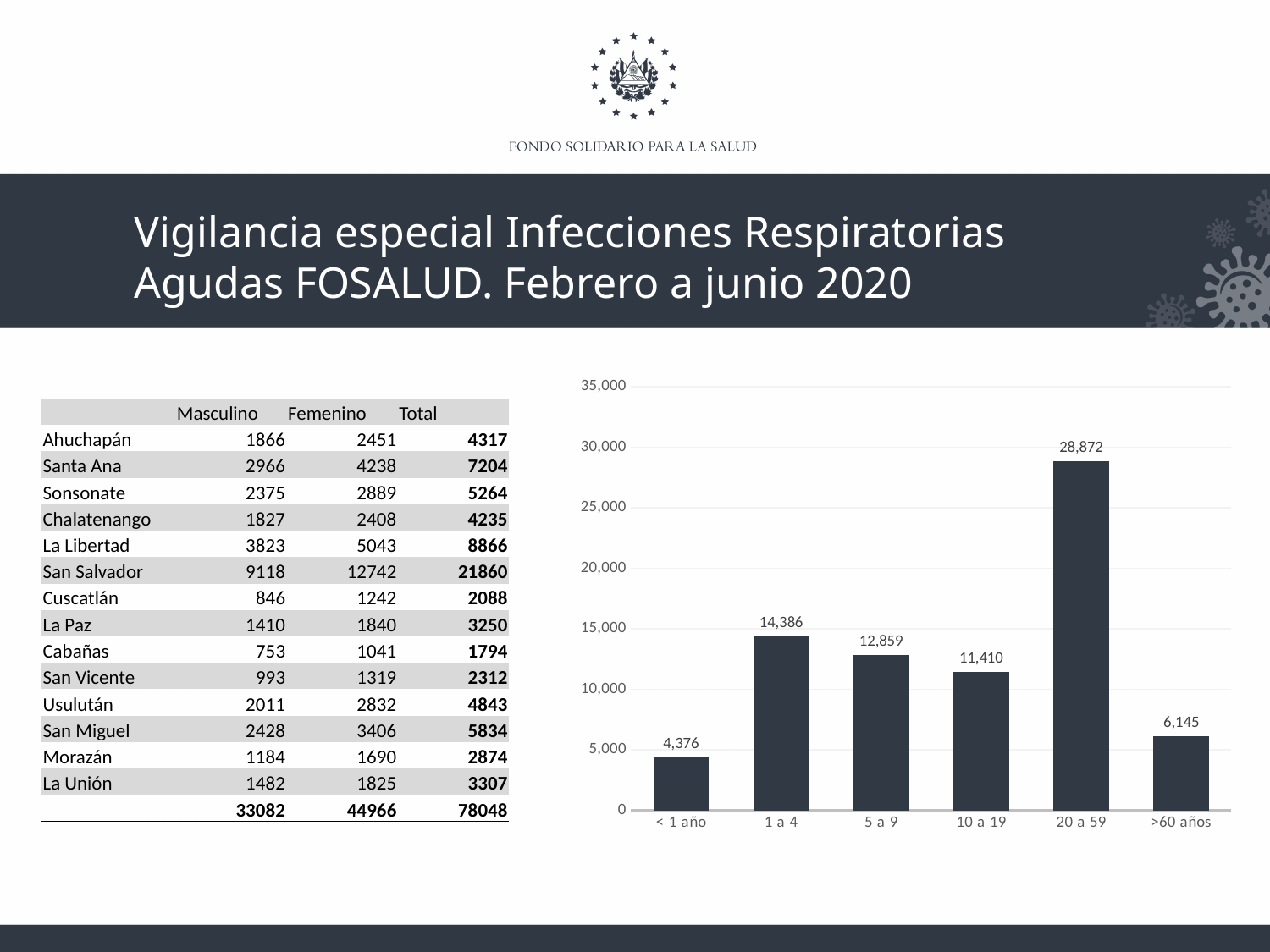
Is the value for 1 a 4 in the bar chart greater or less than 15,000? less What is the difference between the values for 1 a 4 and 5 a 9 in the bar chart? 1,527 Which is larger in the bar chart, the value for 5 a 9 or the value for 10 a 19? 5 a 9 How many age groups are shown in the bar chart? 6 What is the highest value shown on the vertical axis of the bar chart? 35,000 What is the value for the 10 a 19 age group in the bar chart? 11,410 What kind of chart is shown on the right of the slide? bar chart What is the value for the < 1 año age group in the bar chart? 4,376 What is the value for the 20 a 59 age group in the bar chart? 28,872 Which age group has the highest value in the bar chart? 20 a 59 What is the value for the >60 años age group in the bar chart? 6,145 Which age group has the lowest value in the bar chart? < 1 año